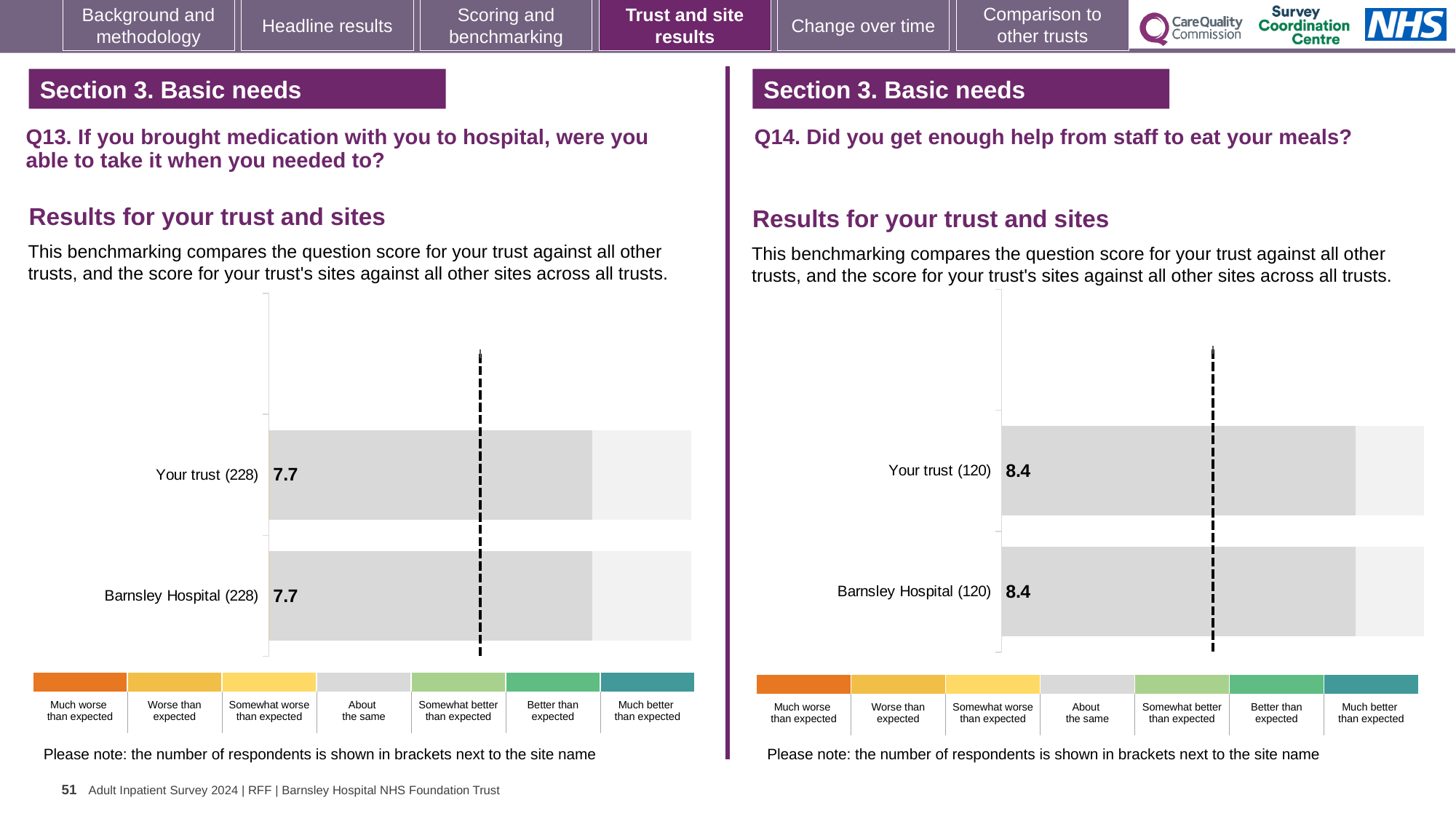
How many bars are plotted in the Q13 chart on the left? 2 In the Q14 chart on the right, what is the score for Barnsley Hospital? 8.4 In the Q13 chart on the left, how many respondents are shown in brackets next to Your trust? 228 In the Q13 chart on the left, what is the score for Barnsley Hospital? 7.7 In the Q14 chart on the right, what is the score for Your trust? 8.4 In the Q13 chart on the left, what is the score for Your trust? 7.7 In the Q13 chart on the left, what is the difference between the Your trust score and the Barnsley Hospital score? 0 In the Q14 chart on the right, how many respondents are shown in brackets next to Barnsley Hospital? 120 In the Q14 chart on the right, what is the difference between the Your trust score and the Barnsley Hospital score? 0 How many bars are plotted in the Q14 chart on the right? 2 What kind of chart is used for the Q13 results on the left? Bar chart Is the Your trust score in the Q14 chart on the right larger or smaller than the Your trust score in the Q13 chart on the left? Larger